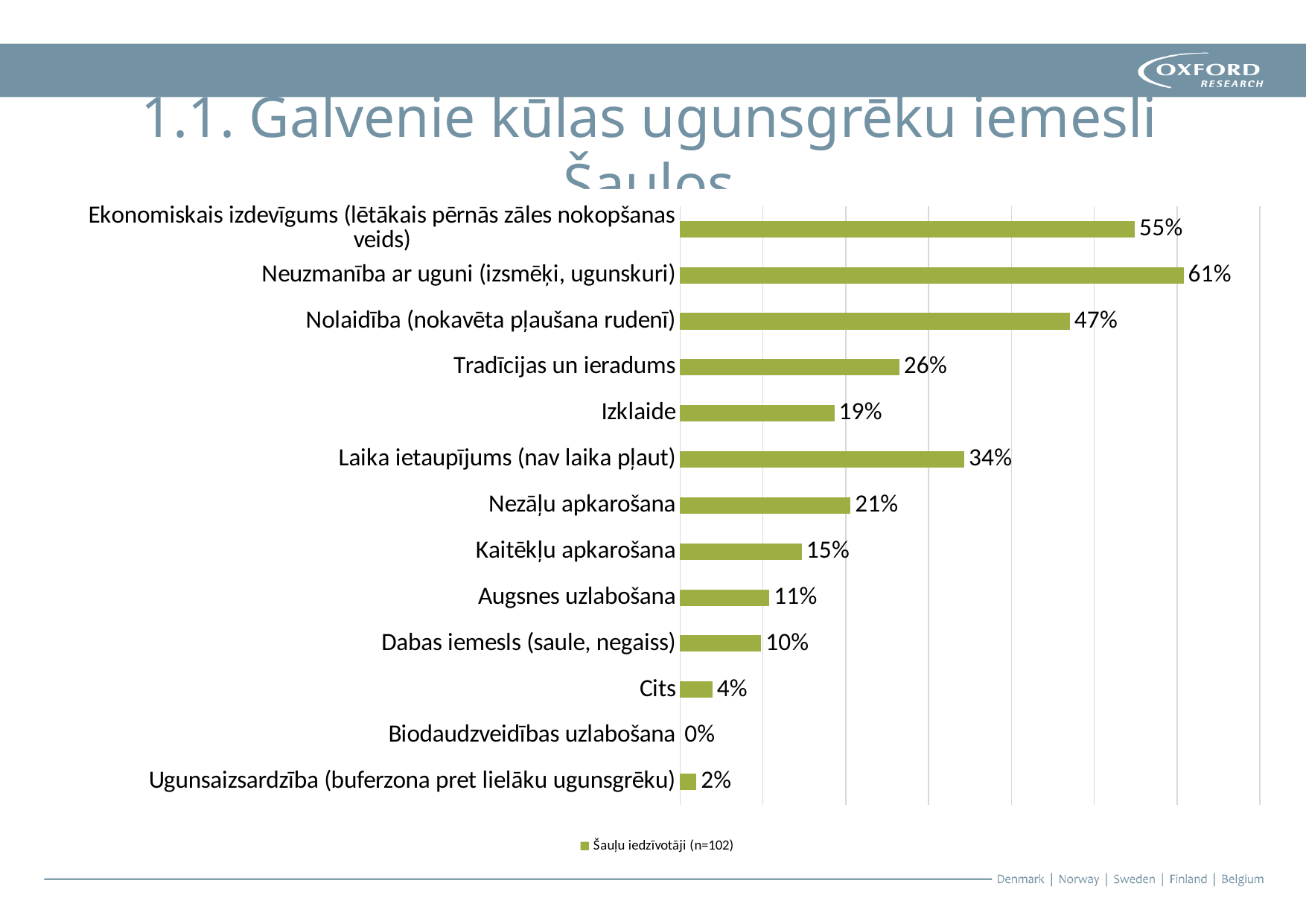
What percentage is shown for Dabas iemesls (saule, negaiss)? 10% How many categories are shown in the chart? 13 What is the difference between the values for Neuzmanība ar uguni (izsmēķi, ugunskuri) and Ekonomiskais izdevīgums (lētākais pērnās zāles nokopšanas veids)? 6% Which is larger, the value for Cits or the value for Ugunsaizsardzība (buferzona pret lielāku ugunsgrēku)? Cits Which category has the highest value? Neuzmanība ar uguni (izsmēķi, ugunskuri) Which is larger, the value for Nezāļu apkarošana or the value for Izklaide? Nezāļu apkarošana What is the value for Laika ietaupījums (nav laika pļaut)? 34% Which category has the lowest value? Biodaudzveidības uzlabošana What is the difference between the values for Nolaidība (nokavēta pļaušana rudenī) and Tradīcijas un ieradums? 21% What kind of chart is shown on the slide? Bar chart What is the legend entry for the series in the chart? Šauļu iedzīvotāji (n=102) What percentage is shown for Neuzmanība ar uguni (izsmēķi, ugunskuri)? 61%